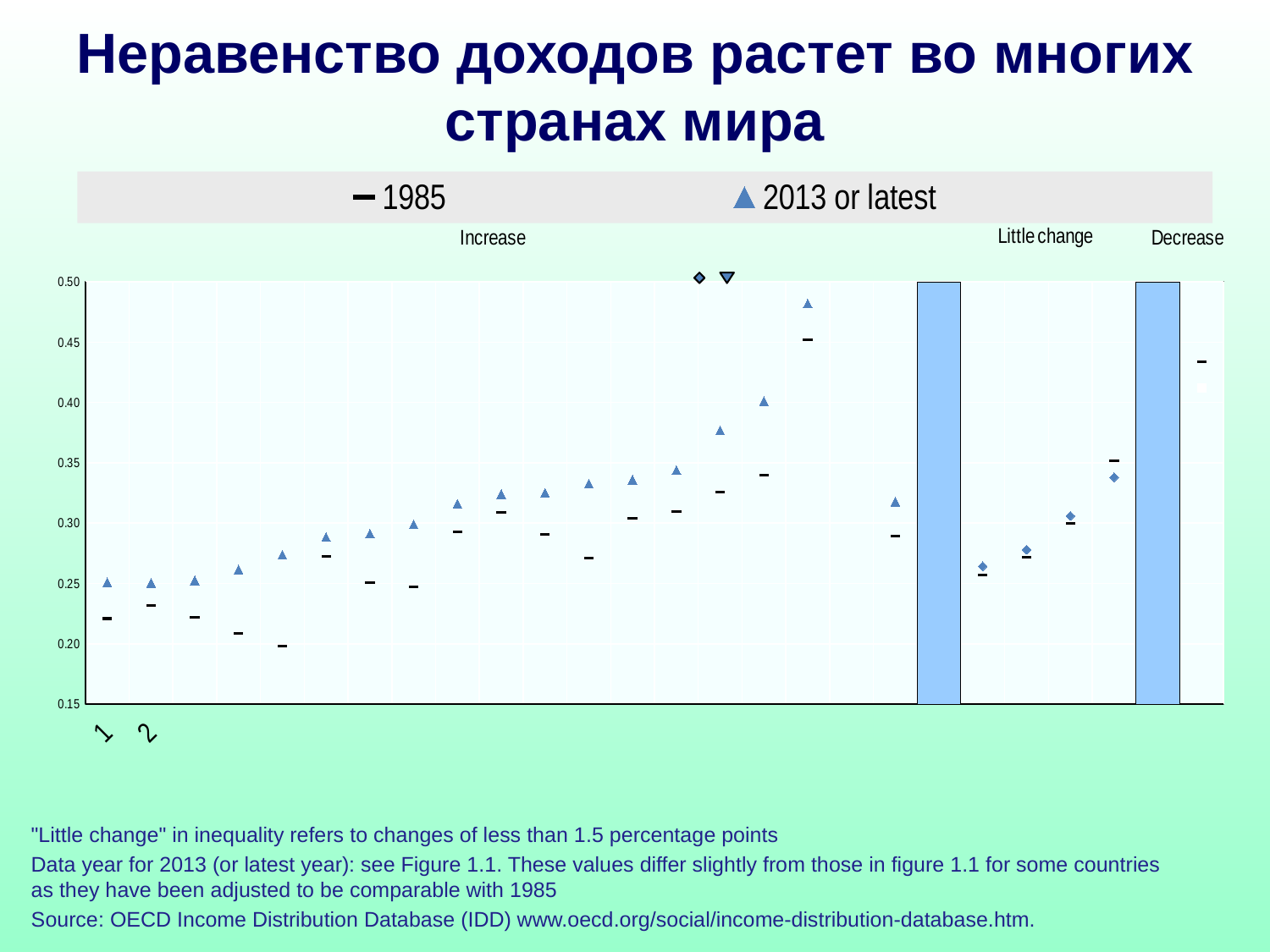
For category 2, which series has the larger value, 1985 or 2013 or latest? 2013 or latest Is the 1985 value for category 2 greater or less than 0.25? less Is the 1985 value for category 1 greater or less than 0.20? greater What are the three group labels shown above the chart area? Increase, Little change, Decrease For category 1, which series has the larger value, 1985 or 2013 or latest? 2013 or latest What are the two series named in the chart legend? 1985 and 2013 or latest Is the 2013 or latest value for category 1 greater or less than 0.30? less How many series does the chart legend list? 2 Within the Increase group, do the 2013 or latest values rise or fall from left to right along the x axis? rise What is the highest value shown on the chart's vertical axis? 0.50